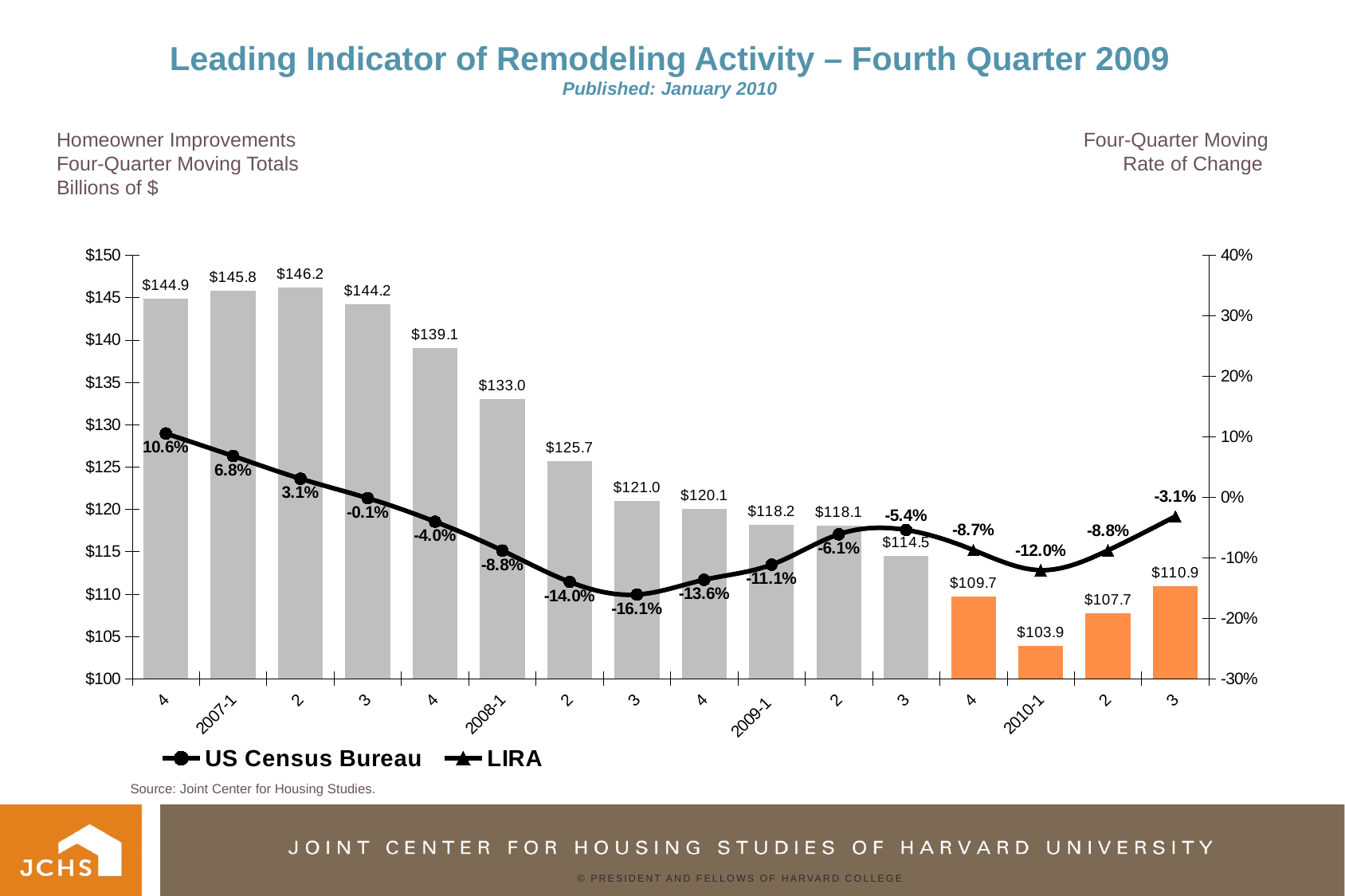
What is the lowest four-quarter moving rate of change shown on the line? -16.1% Do the four-quarter moving totals rise or fall from 2007-1 to 2010-1? Fall What kind of chart is this? Combination bar and line chart What is the four-quarter moving rate of change for 2009-1? -11.1% What is the difference between the four-quarter moving totals for 2009-1 and 2010-1? $14.3 How many series does the legend list? 2 Which is larger, the four-quarter moving total for 2008-1 or for 2009-1? 2008-1 What is the highest four-quarter moving total shown by the bars? $146.2 How many bars are plotted on the chart? 16 Which quarter has the lowest four-quarter moving total? 2010-1 What is the four-quarter moving total for 2010-1? $103.9 What is the four-quarter moving total for 2007-1? $145.8